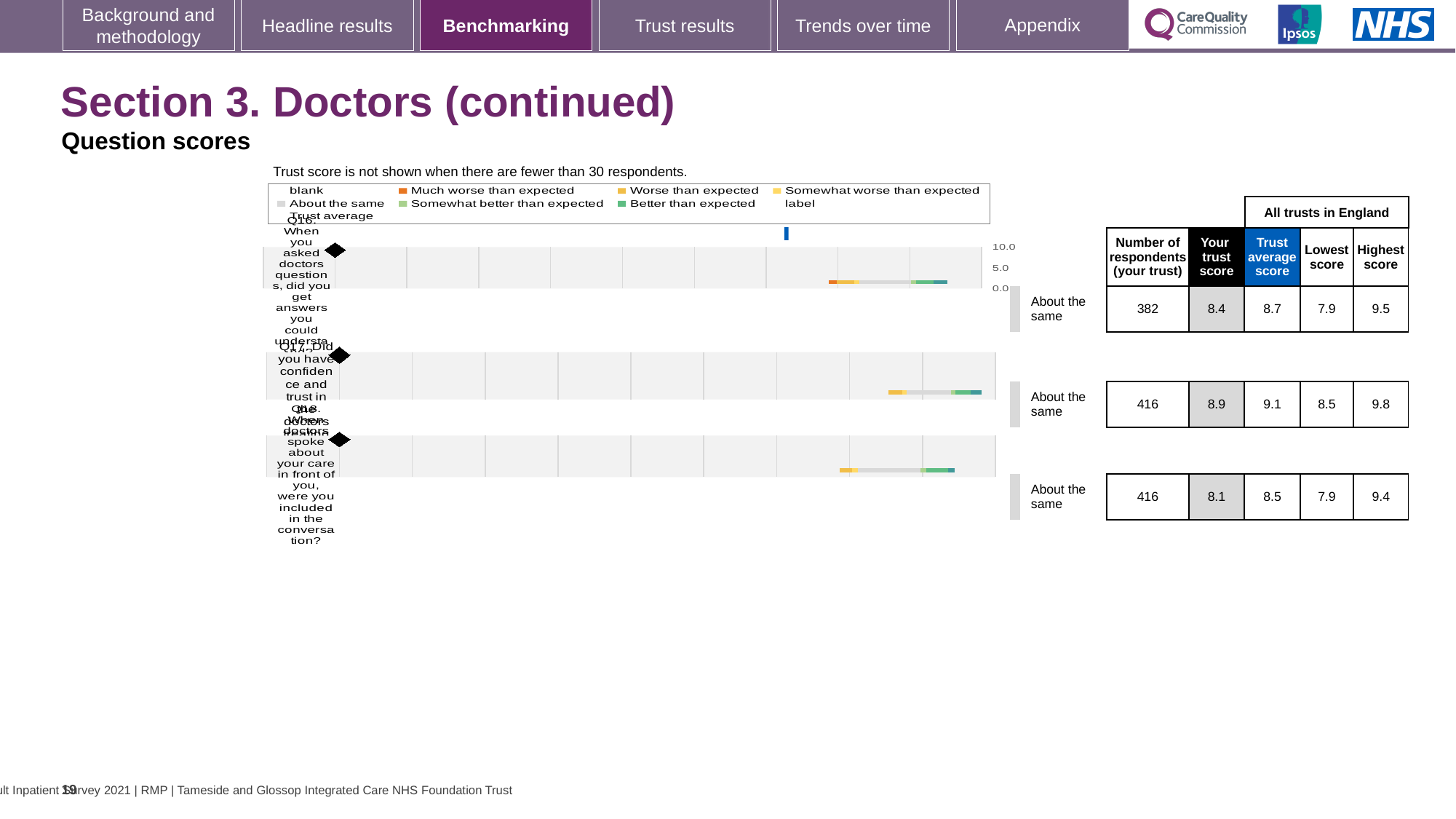
Which question has the highest 'Your trust score'? Q17 What benchmark category is shown for Q18? About the same What is the 'Your trust score' for Q16 (When you asked doctors questions, did you get answers you could understand?)? 8.4 What is the lowest score across all trusts in England for Q16? 7.9 What is the trust average score for Q18 (When doctors spoke about your care in front of you, were you included in the conversation?)? 8.5 How many respondents (your trust) are shown for Q17 (Did you have confidence and trust in the doctors treating you?)? 416 How many questions are plotted in the question scores chart? 3 For Q16, which is larger: the 'Your trust score' or the trust average score? Trust average score What kind of chart is used to show the question scores on this slide? bar chart Which question has the lowest 'Your trust score'? Q18 For Q17, what is the difference between the highest score and the lowest score across all trusts in England? 1.3 What is the highest value shown on the chart's score axis? 10.0